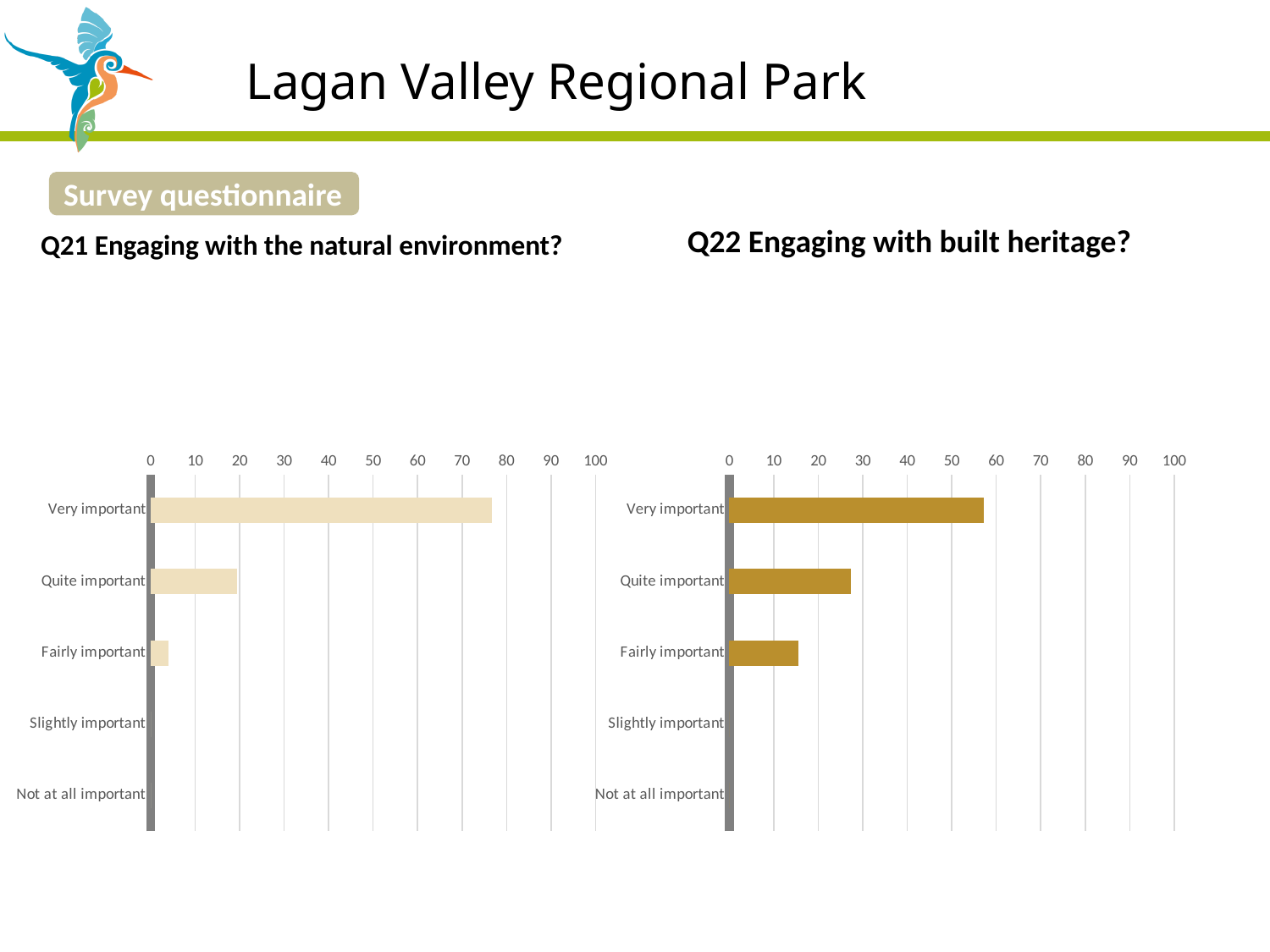
How many categories are shown on the Q22 Engaging with built heritage chart? 5 Which chart has the larger value for Very important, Q21 Engaging with the natural environment or Q22 Engaging with built heritage? Q21 Engaging with the natural environment On the Q21 Engaging with the natural environment chart, is the value for Very important greater or less than 70? greater On the Q22 Engaging with built heritage chart, which is larger, Quite important or Fairly important? Quite important On the Q21 Engaging with the natural environment chart, is the value for Fairly important greater or less than 10? less What is the highest value shown on the x axis of the Q21 Engaging with the natural environment chart? 100 On the Q22 Engaging with built heritage chart, which category has the highest value? Very important What kind of chart is the Q21 Engaging with the natural environment chart? bar chart On the Q21 Engaging with the natural environment chart, which category has the highest value? Very important What is the title of the chart on the right of the slide? Q22 Engaging with built heritage? On the Q22 Engaging with built heritage chart, is the value for Quite important greater or less than 20? greater